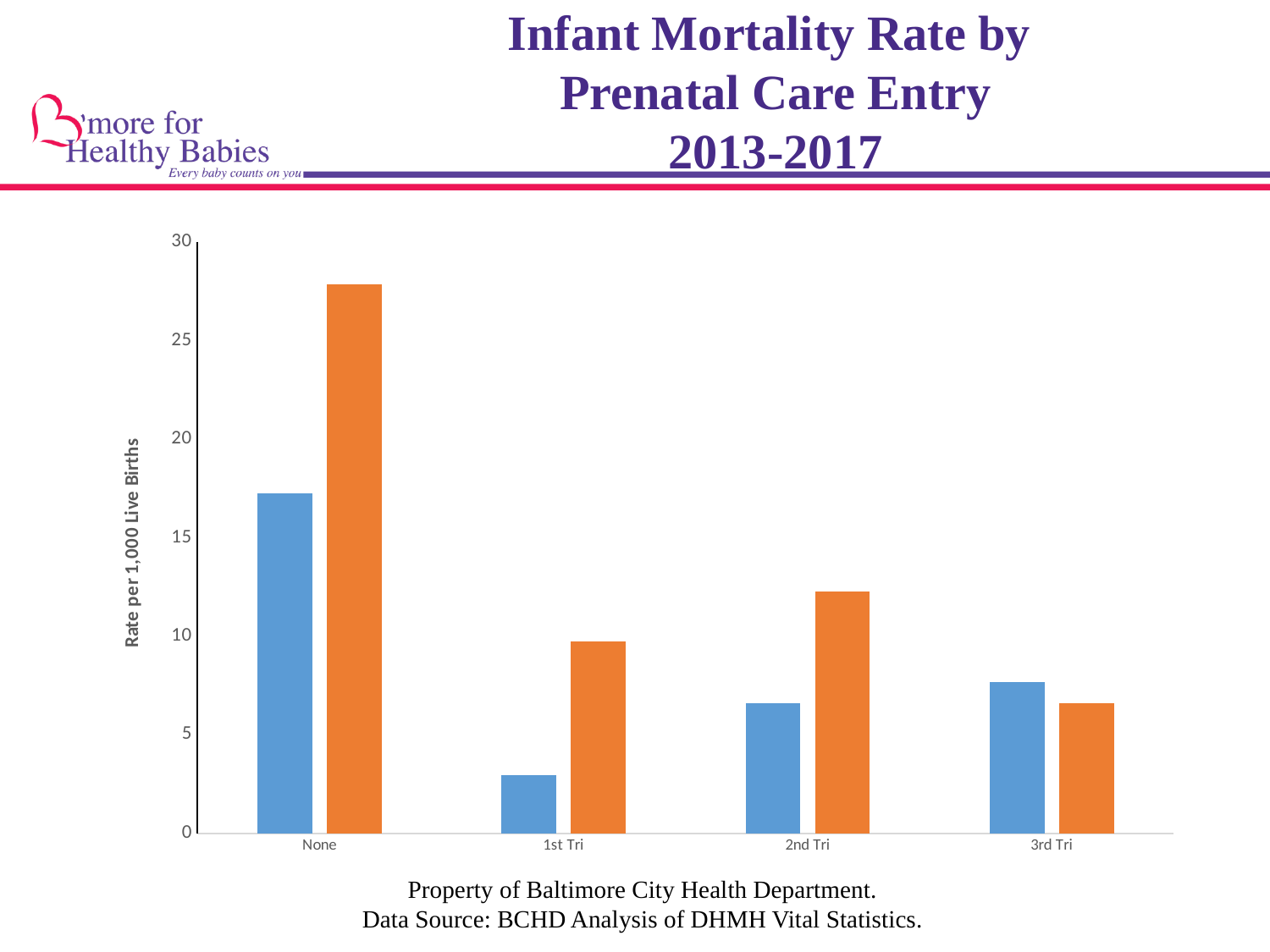
Which category has the tallest orange bar? None For the 3rd Tri category, which bar is taller, the blue bar or the orange bar? blue Is the value of the orange bar for 2nd Tri greater or less than 10? greater For the None category, which bar is taller, the blue bar or the orange bar? orange Is the value of the orange bar for None greater or less than 25? greater How many prenatal care entry categories are shown on the x axis? 4 How many bars are plotted for each category? 2 Which category has the tallest blue bar? None Which category has the shortest blue bar? 1st Tri What kind of chart is shown on the slide? bar chart What is the title of the vertical axis? Rate per 1,000 Live Births Is the value of the blue bar for 1st Tri greater or less than 5? less